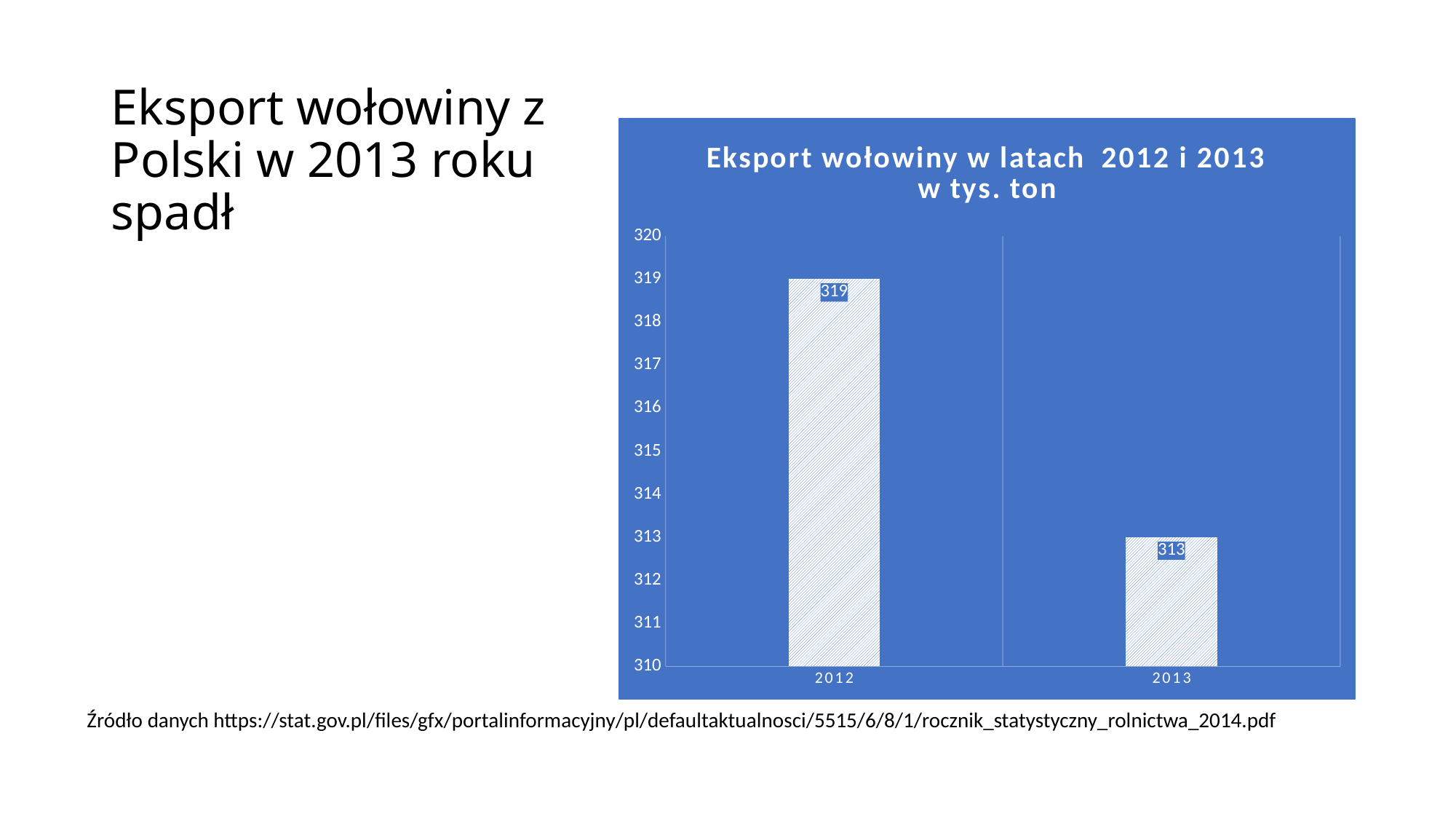
Is the value for 2013 greater or less than 315? less Which is larger, the value for 2012 or the value for 2013? 2012 Which year has the highest value? 2012 What is the value for 2013? 313 How many categories are shown on the x axis? 2 What is the title of the chart? Eksport wołowiny w latach 2012 i 2013 w tys. ton What is the difference between the values for 2012 and 2013? 6 What is the value for 2012? 319 Is the value for 2012 greater or less than 318? greater What kind of chart is shown? bar chart Do the values rise or fall from 2012 to 2013? fall Which year has the lowest value? 2013